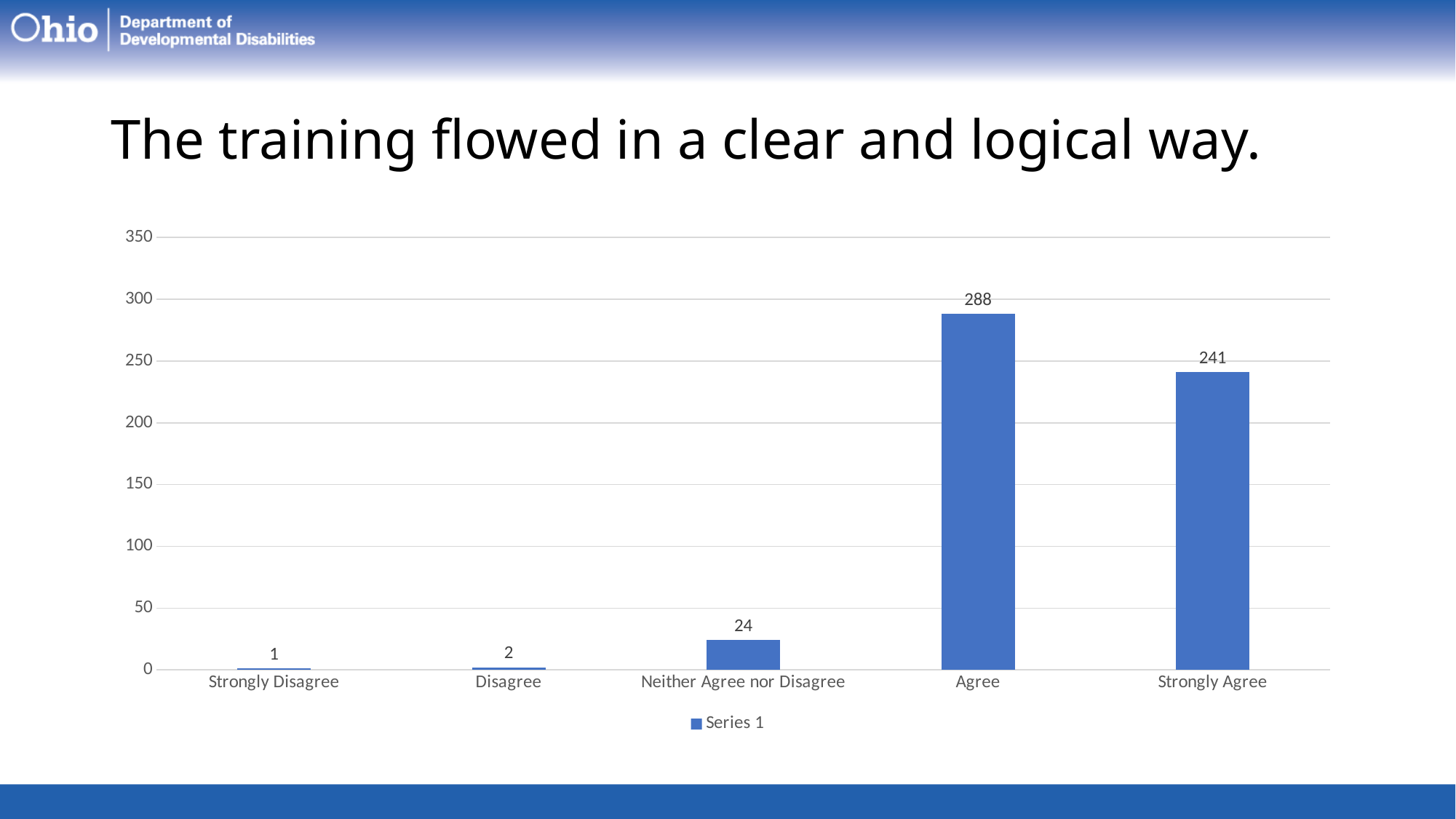
Which category has the lowest value? Strongly Disagree What kind of chart is shown on the slide? bar chart How many categories are shown on the x axis? 5 Which is larger, the value for Disagree or the value for Neither Agree nor Disagree? Neither Agree nor Disagree What is the value for Strongly Disagree? 1 Which category has the highest value? Agree What is the value for Agree? 288 Is the value for Strongly Agree greater or less than 200? greater What is the difference between the values for Agree and Strongly Agree? 47 What is the title of the slide? The training flowed in a clear and logical way. What is the value for Neither Agree nor Disagree? 24 What is the value for Strongly Agree? 241